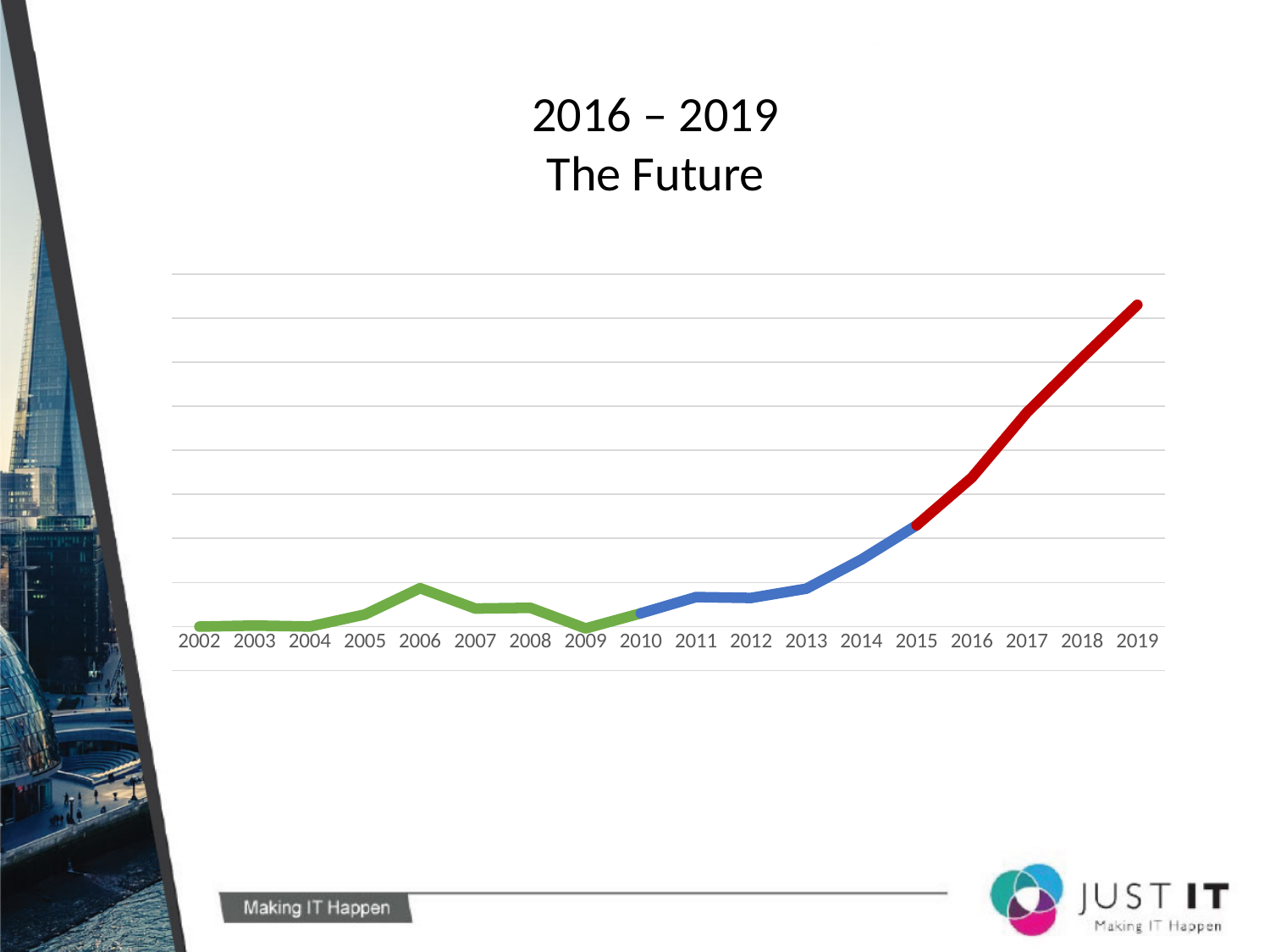
Which year has the larger value, 2006 or 2005? 2006 How many years are labelled along the x axis of the chart? 18 What is the first year shown on the x axis of the chart? 2002 Which year has the larger value, 2006 or 2009? 2006 Which year has the larger value, 2019 or 2002? 2019 Which year has the highest value on the chart? 2019 What colour is the line segment covering 2015 to 2019? red What kind of chart is shown on the slide? line chart Do the values on the chart generally rise or fall from 2010 to 2019? rise